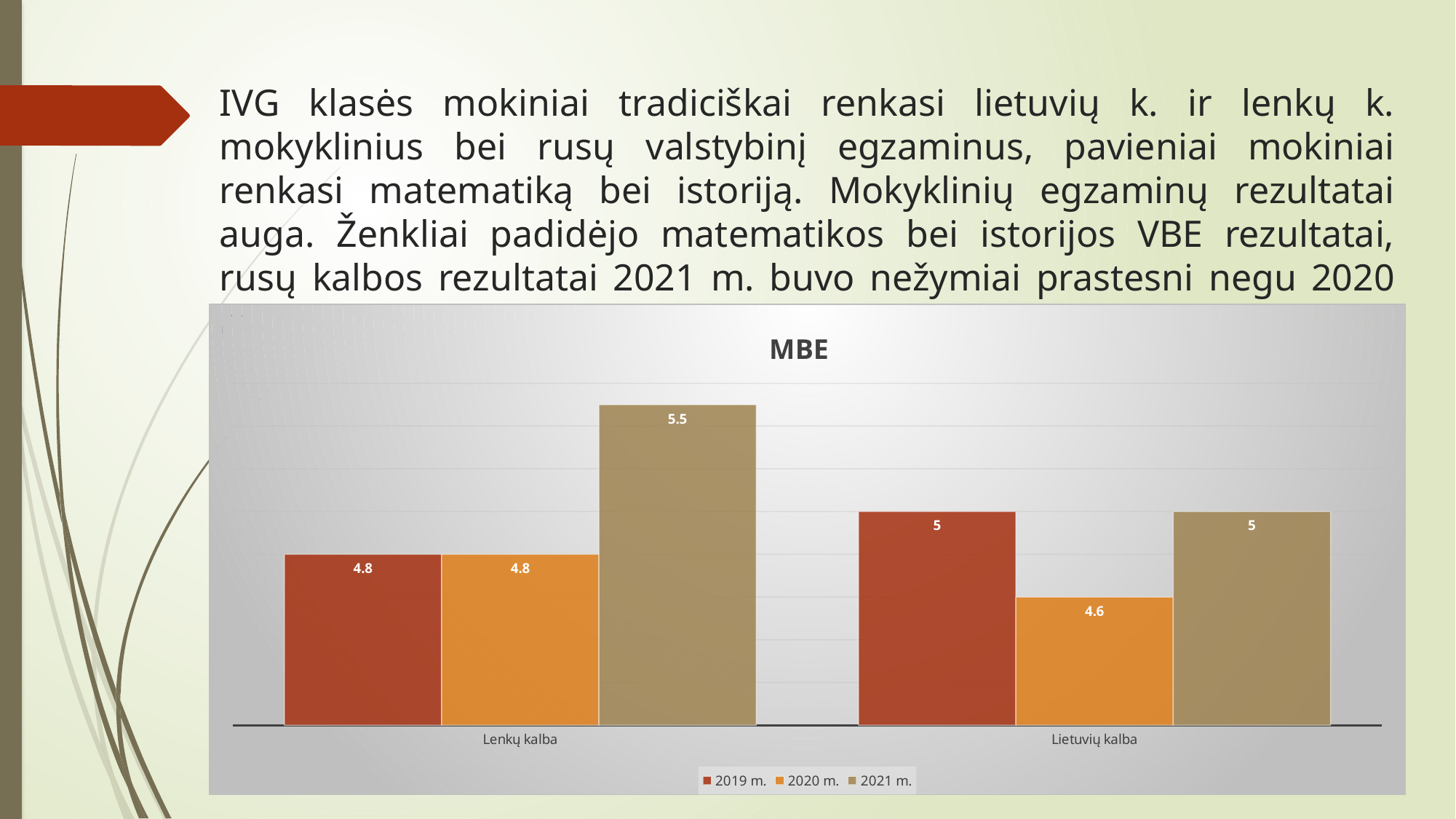
Which is larger: the 2021 m. value for Lenkų kalba or the 2021 m. value for Lietuvių kalba? Lenkų kalba What is the title of the chart? MBE What kind of chart is shown? Bar chart What is the difference between the 2021 m. and 2019 m. values for Lenkų kalba? 0.7 Which year has the lowest value for Lietuvių kalba? 2020 m. How many series does the legend list? 3 What is the difference between the 2019 m. and 2020 m. values for Lietuvių kalba? 0.4 What is the value for Lenkų kalba in 2019 m.? 4.8 What is the value for Lietuvių kalba in 2020 m.? 4.6 What is the value for Lietuvių kalba in 2019 m.? 5 What is the value for Lenkų kalba in 2021 m.? 5.5 Which year has the highest value for Lenkų kalba? 2021 m.